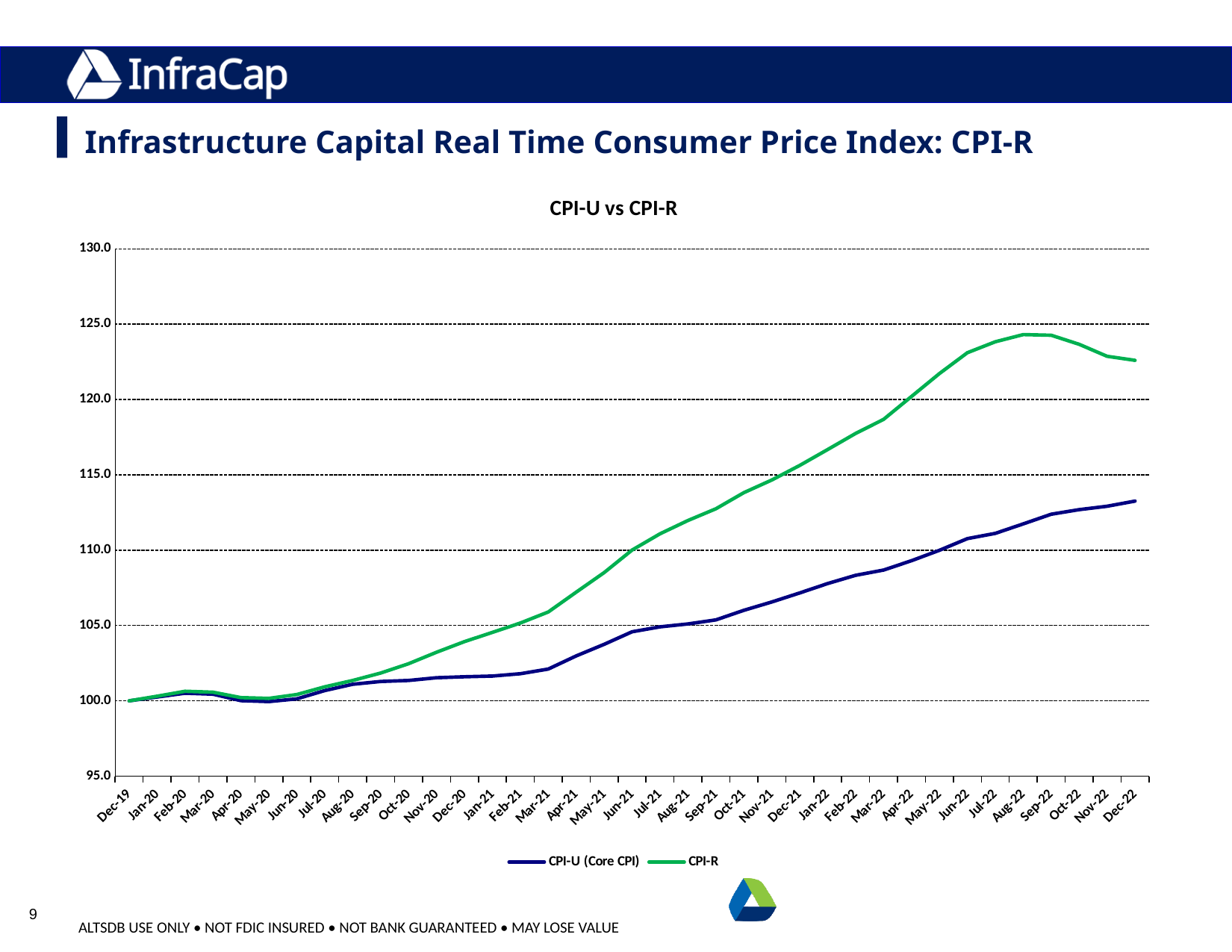
How many series does the legend list? 2 At Dec-22, which series has the higher value, CPI-U (Core CPI) or CPI-R? CPI-R Is the value of CPI-R at Aug-22 greater or less than 120.0? greater Is the value of CPI-R at Apr-21 greater or less than 105.0? greater What kind of chart is shown on the slide? Line chart What is the title of the chart? CPI-U vs CPI-R Does the CPI-U (Core CPI) line generally rise or fall from Dec-19 to Dec-22? Rise Is the value of CPI-U (Core CPI) at Dec-21 greater or less than 105.0? greater What colour is the CPI-R line? Green How many monthly points are plotted along the x axis, from Dec-19 to Dec-22? 37